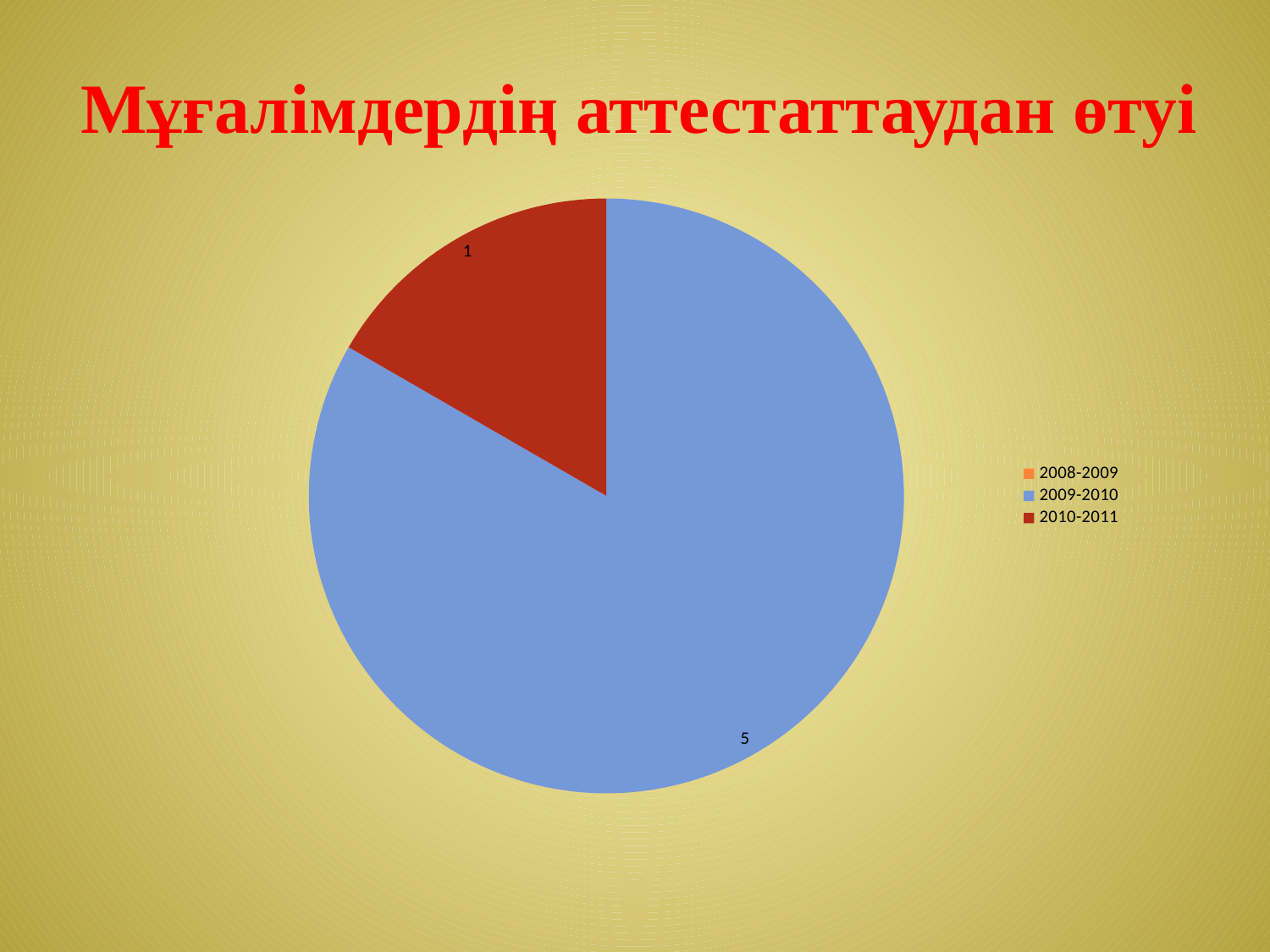
What type of chart is shown on the slide? pie chart What colour is the slice for 2010-2011? red What value is shown for the 2009-2010 slice? 5 How many slices with data labels are visible in the pie? 2 How many entries does the legend list? 3 Which is larger, the value for 2009-2010 or the value for 2010-2011? 2009-2010 What is the difference between the value for 2009-2010 and the value for 2010-2011? 4 Which category has the largest slice of the pie? 2009-2010 What value is shown for the 2010-2011 slice? 1 What is the title of the chart? Мұғалімдердің аттестаттаудан өтуі